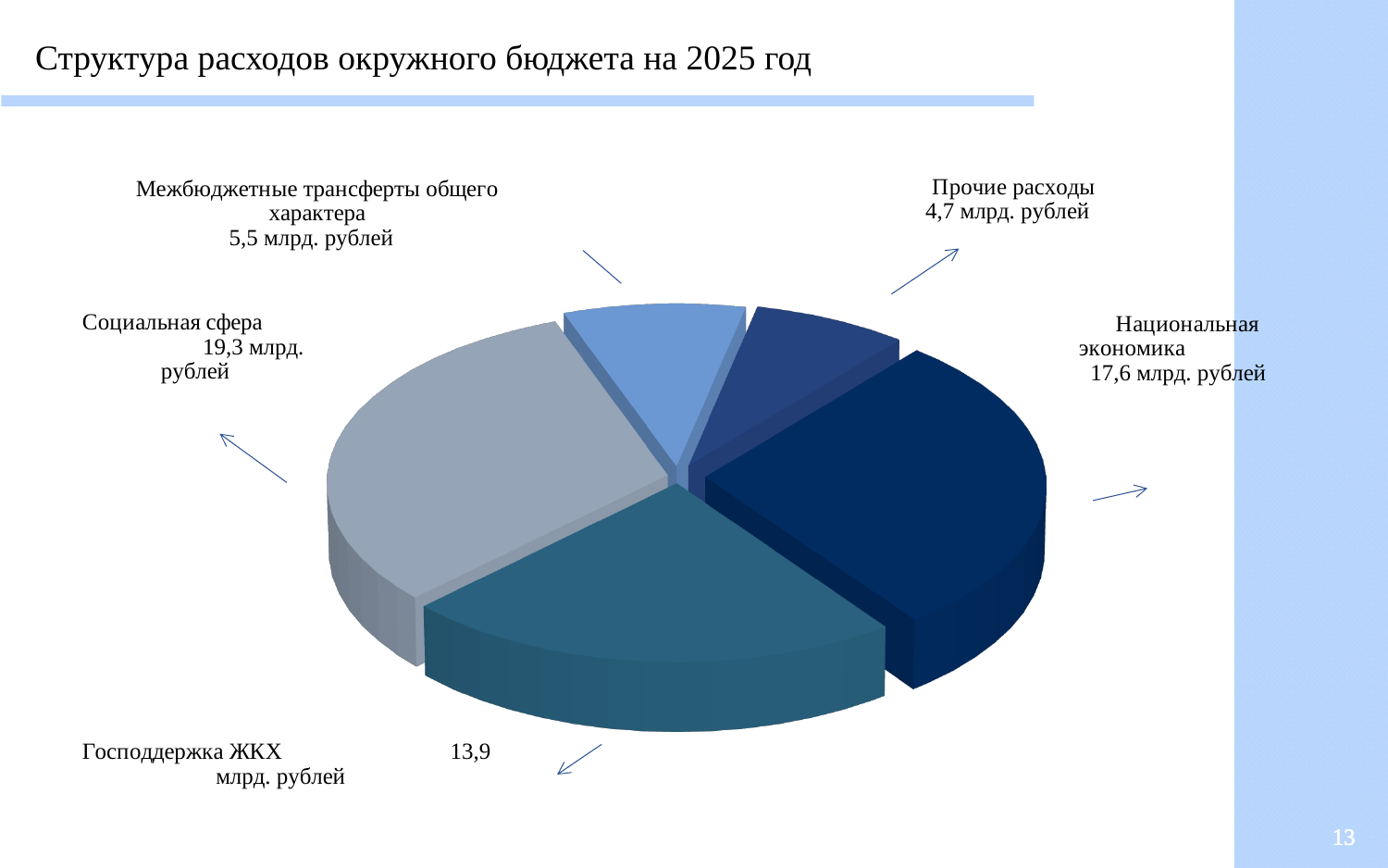
What is the value for Господдержка ЖКХ? 13,9 млрд. рублей What is the value for Социальная сфера? 19,3 млрд. рублей Which is larger, Национальная экономика or Господдержка ЖКХ? Национальная экономика What kind of chart is shown on the slide? Pie chart Which category has the largest share of the pie? Социальная сфера What is the difference between Социальная сфера and Национальная экономика? 1,7 млрд. рублей What is the value for Межбюджетные трансферты общего характера? 5,5 млрд. рублей Which category has the smallest share of the pie? Прочие расходы What is the value for Национальная экономика? 17,6 млрд. рублей How many slices does the pie chart have? 5 What is the total of all the values shown on the pie chart? 61,0 млрд. рублей What is the title of the chart on the slide? Структура расходов окружного бюджета на 2025 год